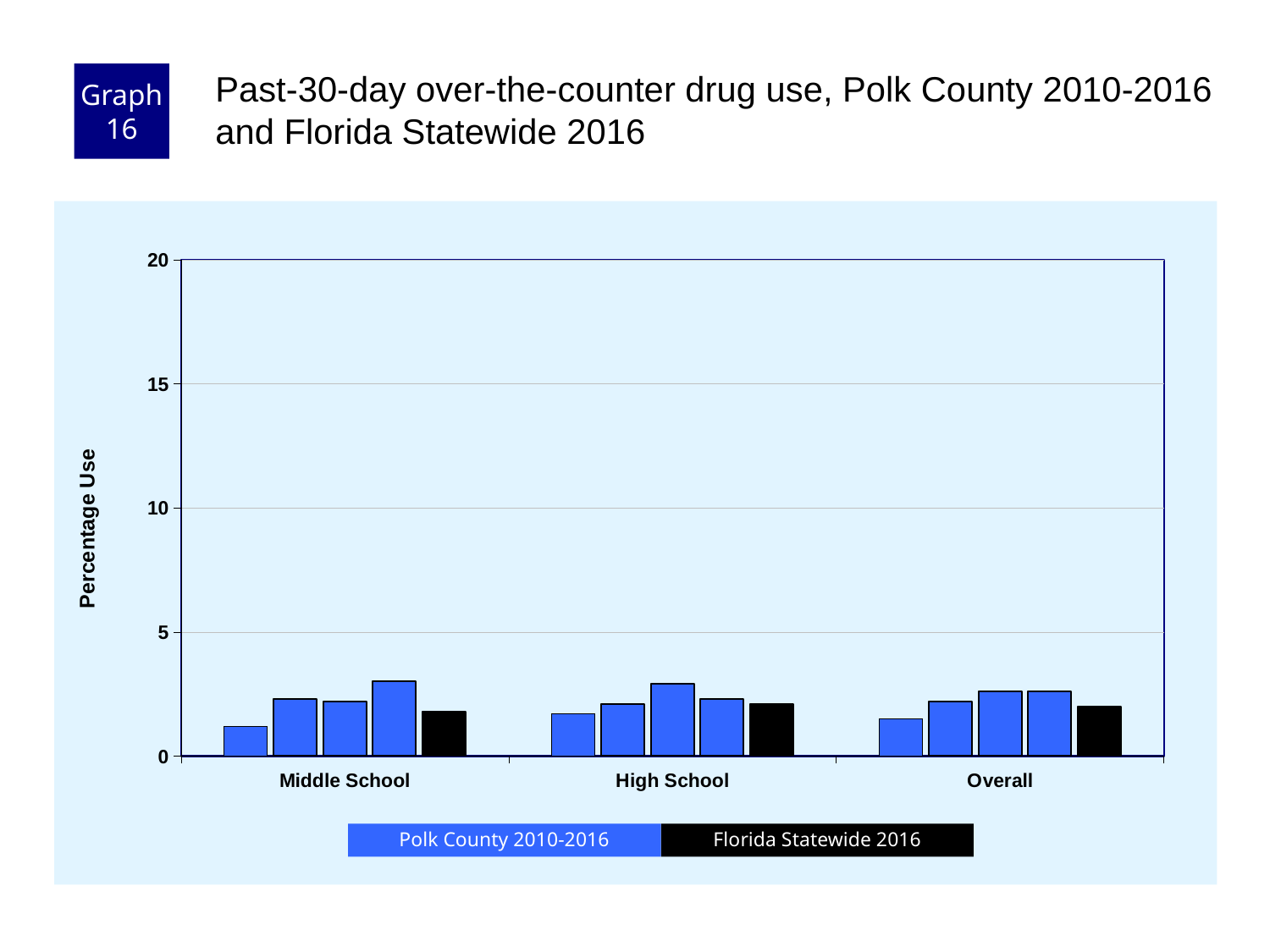
What is the highest value shown on the y axis? 20 Are any of the bars in the Overall group greater than 5? No How many series does the legend list? 2 In the Middle School group, which bar is the lowest? the first Polk County bar In the Middle School group, which is larger: the first Polk County bar or the Florida Statewide 2016 bar? Florida Statewide 2016 What is the label of the y axis? Percentage Use Is the value for Florida Statewide 2016 in the Middle School group greater or less than 5? less Which colour represents Florida Statewide 2016 in the legend? black What kind of chart is shown on the slide? bar chart How many categories are shown along the x axis? 3 Is the value for Florida Statewide 2016 in the High School group greater or less than 5? less In the Middle School group, which Polk County bar is the tallest? the fourth (last) Polk County bar